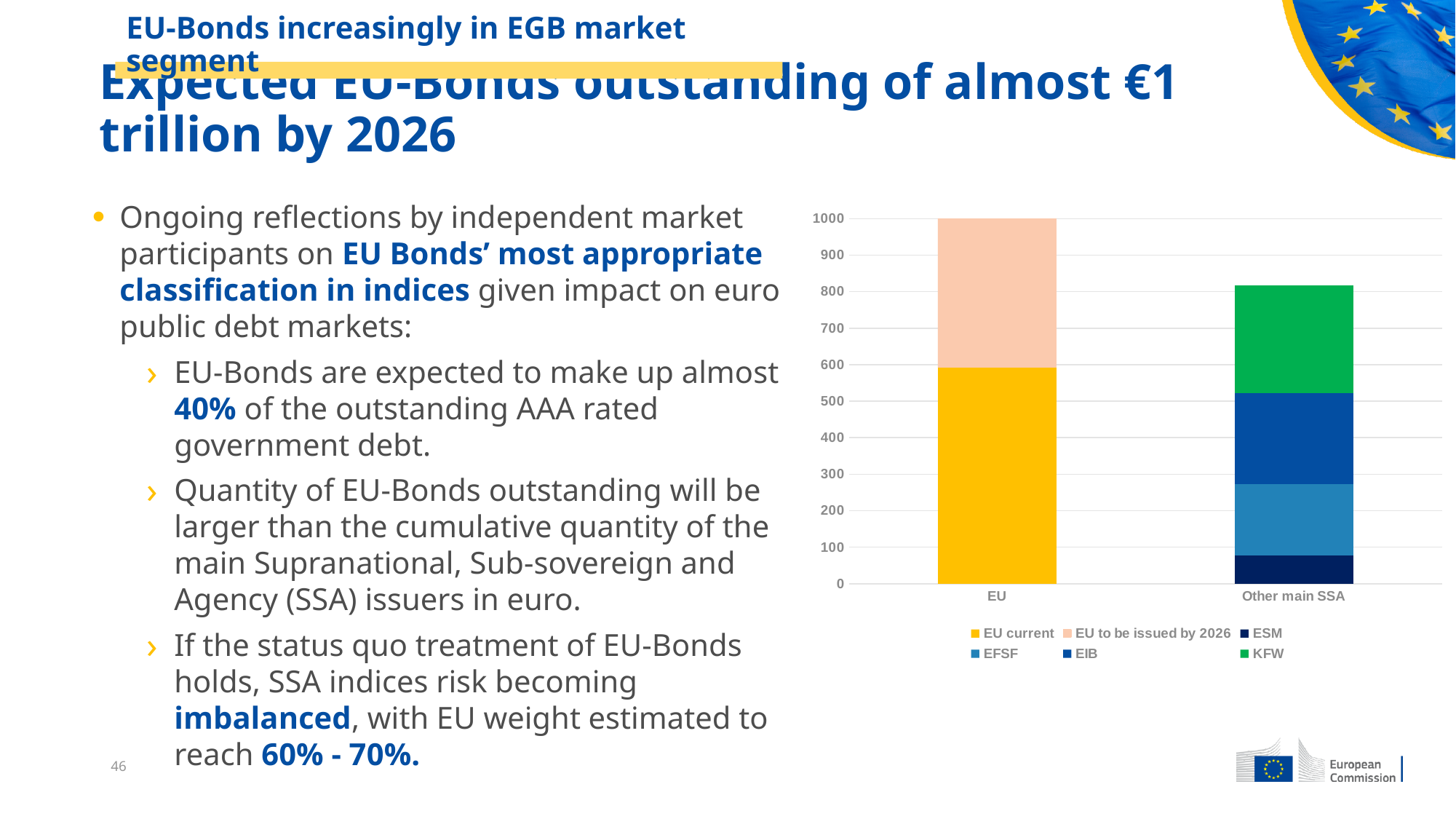
What kind of chart is shown on the slide? Stacked bar chart How many categories are shown on the x axis of the chart? 2 Which category has the taller stacked bar, EU or Other main SSA? EU Is the value of the ESM segment greater or less than 100? less Is the total height of the EU bar greater or less than 900? greater Is the value of the EU current segment greater or less than 500? greater How many series does the chart's legend list? 6 Within the EU bar, which segment is larger, EU current or EU to be issued by 2026? EU current What colour represents KFW in the chart's legend? Green Which segment is larger, KFW or ESM? KFW